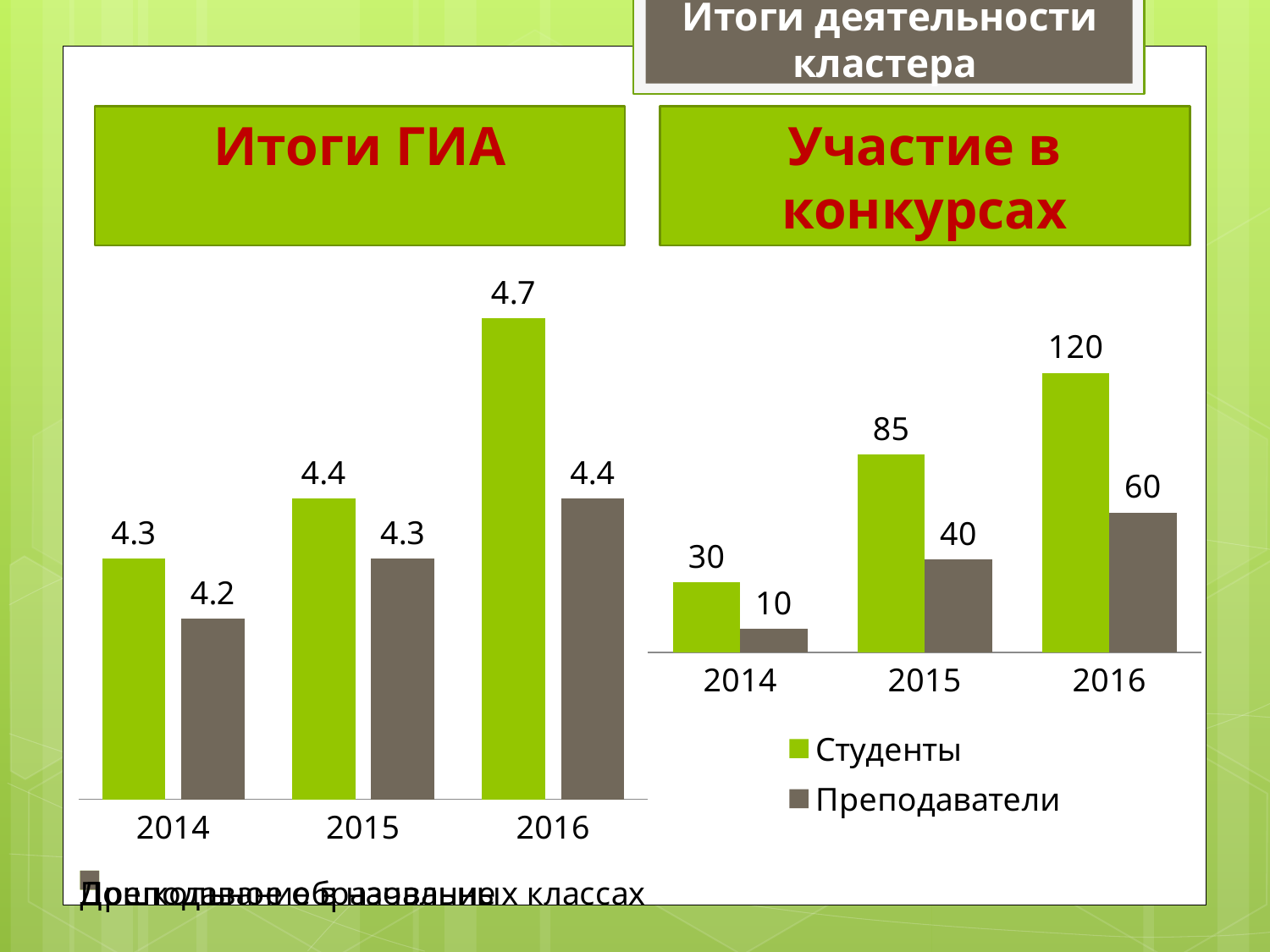
In the 'Участие в конкурсах' chart, which year has the lowest value for Преподаватели? 2014 What kind of chart is the 'Итоги ГИА' chart? bar chart In the 'Участие в конкурсах' chart, what is the difference between the Студенты values for 2016 and 2015? 35 In the 'Участие в конкурсах' chart, do the Преподаватели values rise or fall from 2014 to 2016? rise In the 'Участие в конкурсах' chart, which is larger: Студенты in 2015 or Преподаватели in 2016? Студенты in 2015 In the 'Участие в конкурсах' chart, what is the value for Студенты in 2016? 120 In the 'Итоги ГИА' chart, how many years are shown on the x axis? 3 In the 'Итоги ГИА' chart, what is the value of the green bar for 2016? 4.7 In the 'Участие в конкурсах' chart, how many series does the legend list? 2 In the 'Итоги ГИА' chart, what is the value of the grey bar for 2014? 4.2 In the 'Участие в конкурсах' chart, what is the value for Преподаватели in 2014? 10 In the 'Участие в конкурсах' chart, which year has the highest value for Студенты? 2016